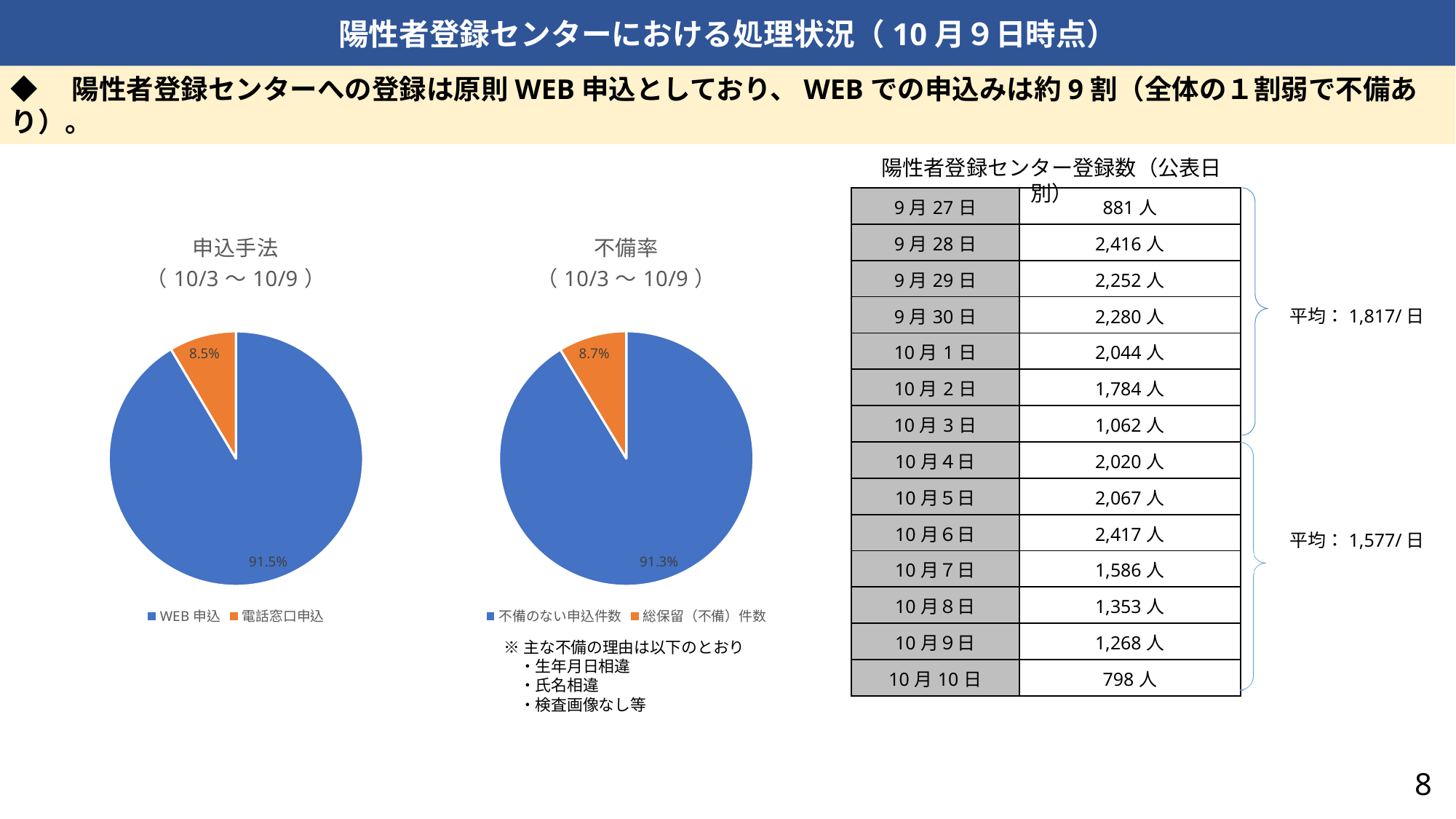
In the 不備率 pie chart, which category has the smallest share? 総保留（不備）件数 In the 不備率 pie chart, what colour is the 総保留（不備）件数 slice? Orange In the 申込手法 (10/3～10/9) pie chart, what share is WEB 申込? 91.5% In the 不備率 (10/3～10/9) pie chart, what share is 総保留（不備）件数? 8.7% In the 不備率 (10/3～10/9) pie chart, what share is 不備のない申込件数? 91.3% In the 申込手法 (10/3～10/9) pie chart, what share is 電話窓口申込? 8.5% How many categories does the 不備率 pie chart show? 2 In the 申込手法 pie chart, which category has the largest share? WEB 申込 In the 申込手法 pie chart, what is the difference between the WEB 申込 share and the 電話窓口申込 share? 83.0% Which is larger: the 電話窓口申込 share in the 申込手法 chart or the 総保留（不備）件数 share in the 不備率 chart? 総保留（不備）件数 (8.7%) What type of chart is the 申込手法 (10/3～10/9) chart? Pie chart How many entries does the legend of the 申込手法 pie chart list? 2